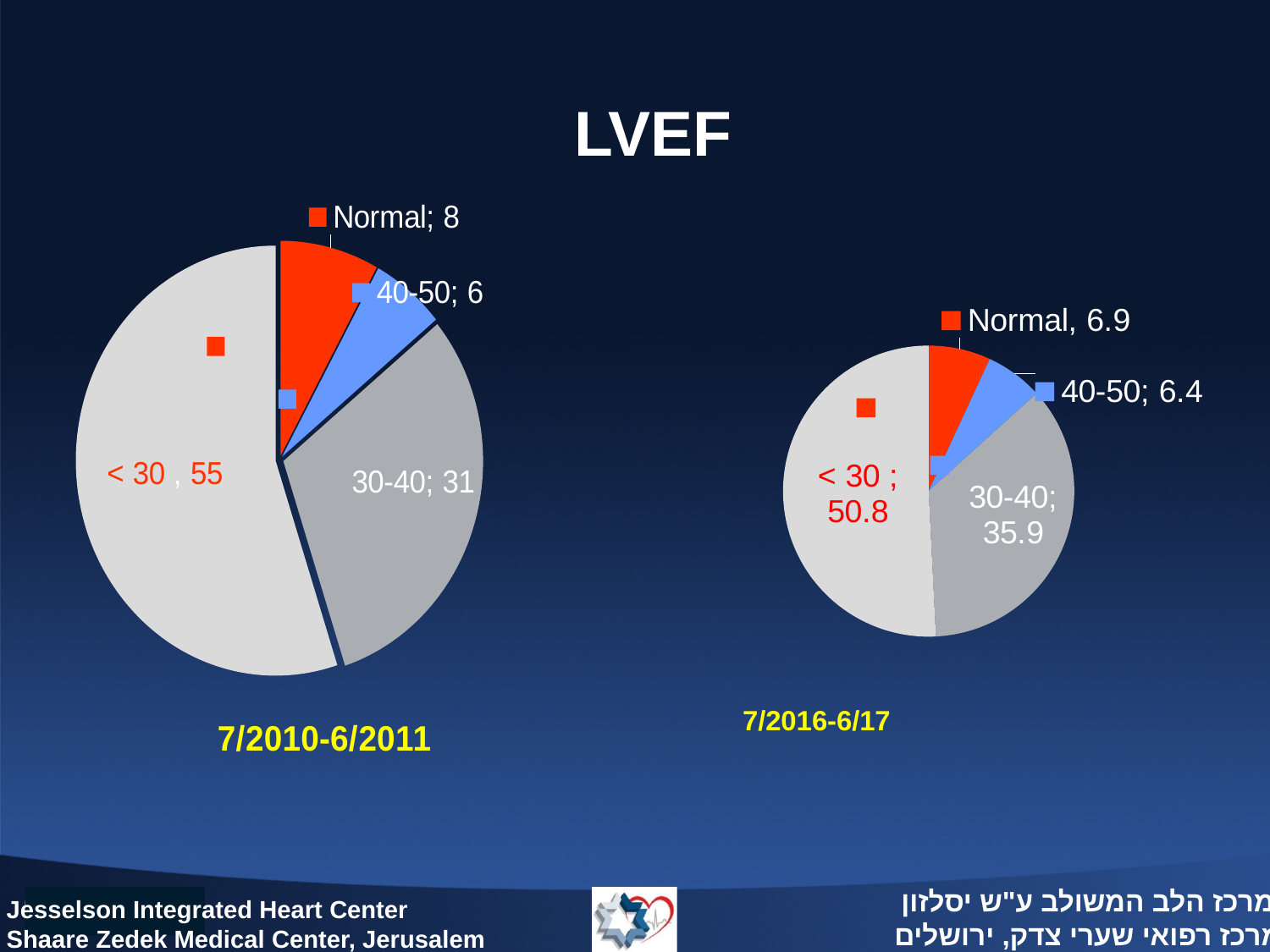
What is the title of the slide? LVEF In the 7/2016-6/17 chart, which category has the largest slice? < 30 In the 7/2010-6/2011 chart, which category has the smallest slice? 40-50 In the 7/2010-6/2011 chart, what is the difference between the < 30 value and the 30-40 value? 24 What type of charts are shown on the slide? Pie charts In the 7/2010-6/2011 chart, what is the value for the 30-40 category? 31 In the 7/2016-6/17 chart, what is the value for the 30-40 category? 35.9 In the 7/2016-6/17 chart, what is the difference between the 30-40 value and the 40-50 value? 29.5 Which is larger: the 30-40 value in the 7/2010-6/2011 chart or the 30-40 value in the 7/2016-6/17 chart? 7/2016-6/17 In the 7/2010-6/2011 chart, what is the value for the < 30 category? 55 In the 7/2016-6/17 chart, what is the value for the Normal category? 6.9 How many categories does each pie chart have? 4